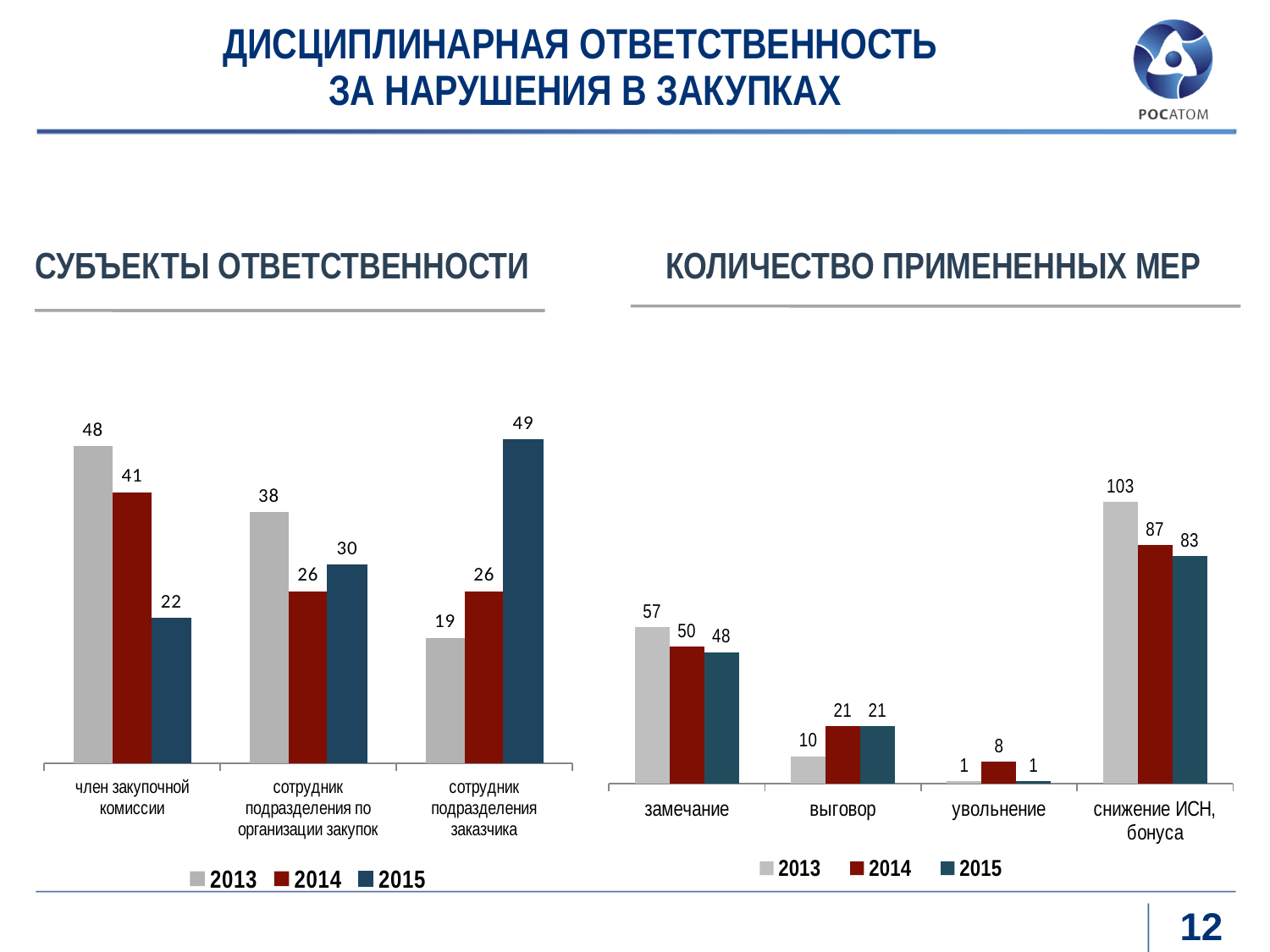
In the 'КОЛИЧЕСТВО ПРИМЕНЕННЫХ МЕР' chart, which is larger: 'выговор' in 2013 or 'выговор' in 2014? выговор in 2014 In the 'СУБЪЕКТЫ ОТВЕТСТВЕННОСТИ' chart, what is the difference between the 2013 and 2015 values for 'член закупочной комиссии'? 26 In the 'КОЛИЧЕСТВО ПРИМЕНЕННЫХ МЕР' chart, what is the value for 'увольнение' in 2014? 8 In the 'КОЛИЧЕСТВО ПРИМЕНЕННЫХ МЕР' chart, which category has the lowest value in 2015? увольнение In the 'СУБЪЕКТЫ ОТВЕТСТВЕННОСТИ' chart, do the values for 'сотрудник подразделения заказчика' rise or fall from 2013 to 2015? rise How many categories are shown on the x axis of the 'КОЛИЧЕСТВО ПРИМЕНЕННЫХ МЕР' chart? 4 How many series does the legend of the 'СУБЪЕКТЫ ОТВЕТСТВЕННОСТИ' chart list? 3 In the 'СУБЪЕКТЫ ОТВЕТСТВЕННОСТИ' chart, what is the value for 'сотрудник подразделения заказчика' in 2013? 19 In the 'СУБЪЕКТЫ ОТВЕТСТВЕННОСТИ' chart, what is the value for 'член закупочной комиссии' in 2015? 22 In the 'КОЛИЧЕСТВО ПРИМЕНЕННЫХ МЕР' chart, what is the value for 'снижение ИСН, бонуса' in 2013? 103 In the 'КОЛИЧЕСТВО ПРИМЕНЕННЫХ МЕР' chart, what is the difference between the 2013 and 2014 values for 'замечание'? 7 In the 'СУБЪЕКТЫ ОТВЕТСТВЕННОСТИ' chart, which category has the highest value in 2015? сотрудник подразделения заказчика